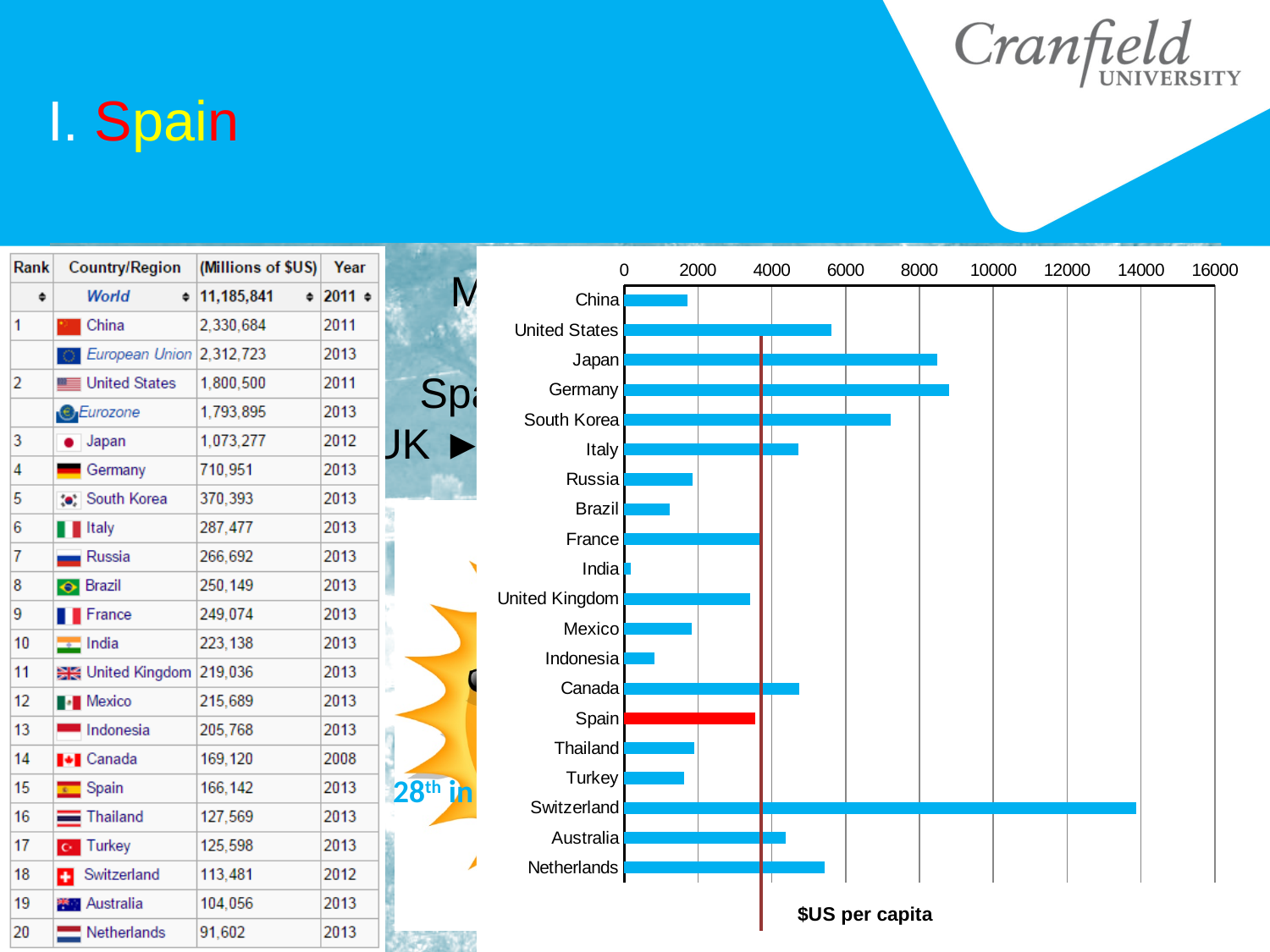
Which country has the highest value in the bar chart? Switzerland How many countries are plotted in the bar chart? 20 Is the value for Spain greater or less than 4000? less What kind of chart is shown on the slide? bar chart Is the value for Switzerland greater or less than 12000? greater What is the label on the horizontal axis of the bar chart? $US per capita Which has a larger value, Germany or Italy? Germany Is the value for India greater or less than 2000? less Which has a larger value, Netherlands or China? Netherlands Which country has the lowest value in the bar chart? India